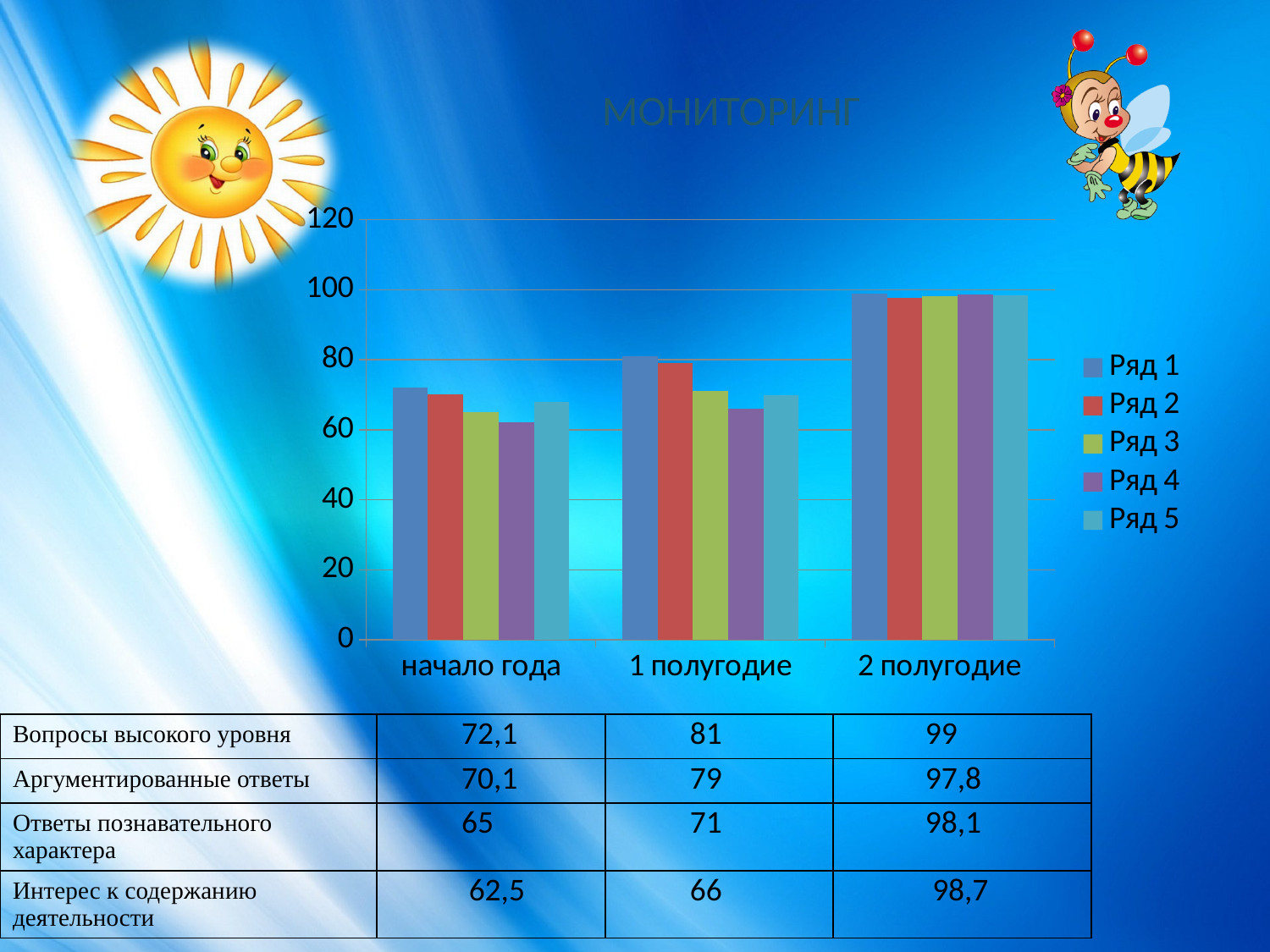
What is the title of the chart on the slide? МОНИТОРИНГ Which category has the highest values across all series? 2 полугодие Is the value for Ряд 3 at 2 полугодие greater or less than 100? less At начало года, which is larger: Ряд 1 or Ряд 4? Ряд 1 How many series does the chart legend list? 5 Is the value for Ряд 1 at начало года greater or less than 60? greater At 1 полугодие, which is larger: Ряд 4 or Ряд 1? Ряд 1 Which category has the lowest values across all series? начало года Do the values for Ряд 1 rise or fall from начало года to 2 полугодие? rise Is the value for Ряд 4 at 1 полугодие greater or less than 80? less What kind of chart is shown on the slide? bar chart How many categories are shown on the x axis of the chart? 3